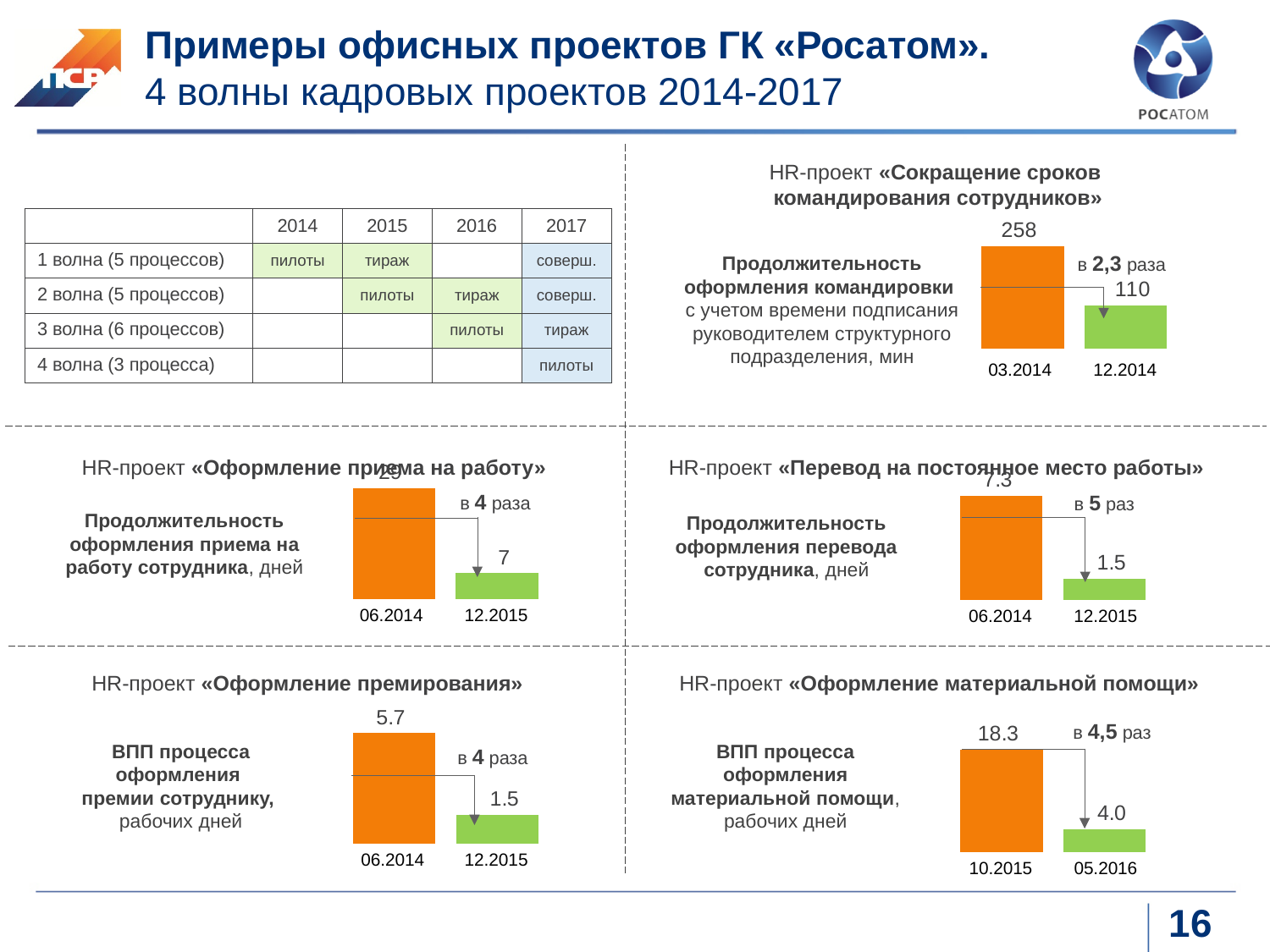
In the chart for the HR project «Оформление материальной помощи», what is the value for 05.2016? 4.0 In the chart for the HR project «Оформление приема на работу», what is the value for 12.2015? 7 In the chart for the HR project «Оформление материальной помощи», what is the value for 10.2015? 18.3 In the chart for the HR project «Перевод на постоянное место работы», what is the value for 06.2014? 7.3 What kind of chart is used for the HR project «Оформление материальной помощи»? Bar chart In the chart for the HR project «Сокращение сроков командирования сотрудников», what is the difference between the 03.2014 and 12.2014 values? 148 In the chart for the HR project «Оформление приема на работу», which period has the higher value, 06.2014 or 12.2015? 06.2014 In the chart for the HR project «Перевод на постоянное место работы», what is the value for 12.2015? 1.5 In the chart for the HR project «Сокращение сроков командирования сотрудников», what is the value for 03.2014? 258 In the chart for the HR project «Сокращение сроков командирования сотрудников», what is the value for 12.2014? 110 In the chart for the HR project «Оформление премирования», what is the value for 06.2014? 5.7 In the chart for the HR project «Оформление премирования», what is the difference between the 06.2014 and 12.2015 values? 4.2